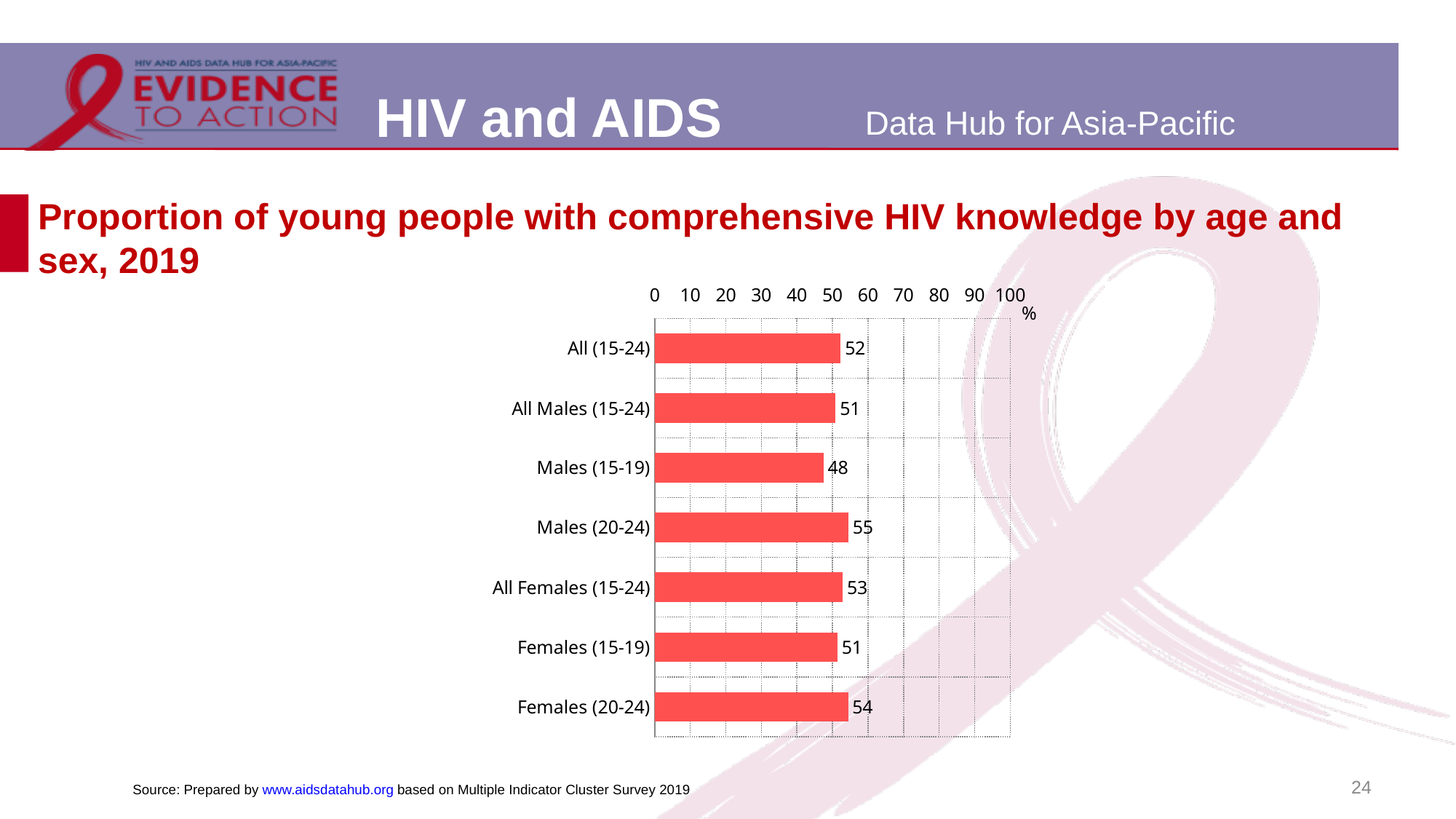
What kind of chart is shown on the slide? bar chart What is the value for Males (15-19)? 48 How many categories are shown in the chart? 7 What is the value for All (15-24)? 52 What is the maximum value shown on the chart's axis? 100 Is the value for Males (15-19) greater or less than 50? less What is the value for Females (20-24)? 54 Which category has the highest value? Males (20-24) Which category has the lowest value? Males (15-19) What is the difference between the values for Males (20-24) and Males (15-19)? 7 What is the difference between the values for All Females (15-24) and All Males (15-24)? 2 Which is larger, the value for Females (20-24) or the value for Females (15-19)? Females (20-24)